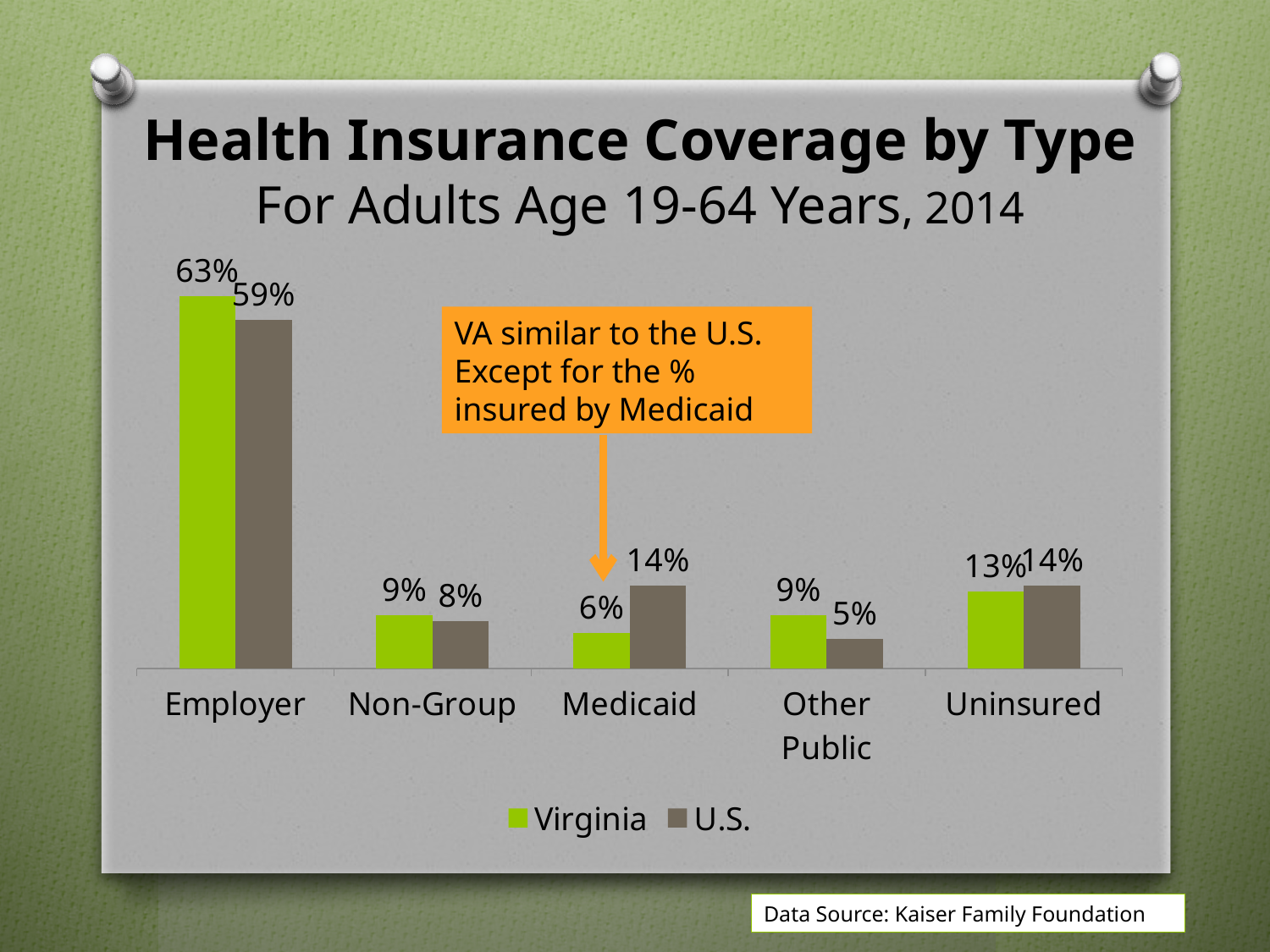
What is the difference between the U.S. and Virginia values for Medicaid? 8% Which is larger for Other Public coverage, the Virginia value or the U.S. value? Virginia Which coverage type has the lowest U.S. value? Other Public What is the Virginia value for Uninsured? 13% What is the U.S. value for Medicaid coverage? 14% What kind of chart is shown on the slide? Bar chart Which series is shown in green in the legend? Virginia Which coverage type has the highest Virginia value? Employer How many coverage types are shown on the x axis? 5 What is the U.S. value for Other Public coverage? 5% How many series does the legend list? 2 What is the Virginia value for Employer coverage? 63%